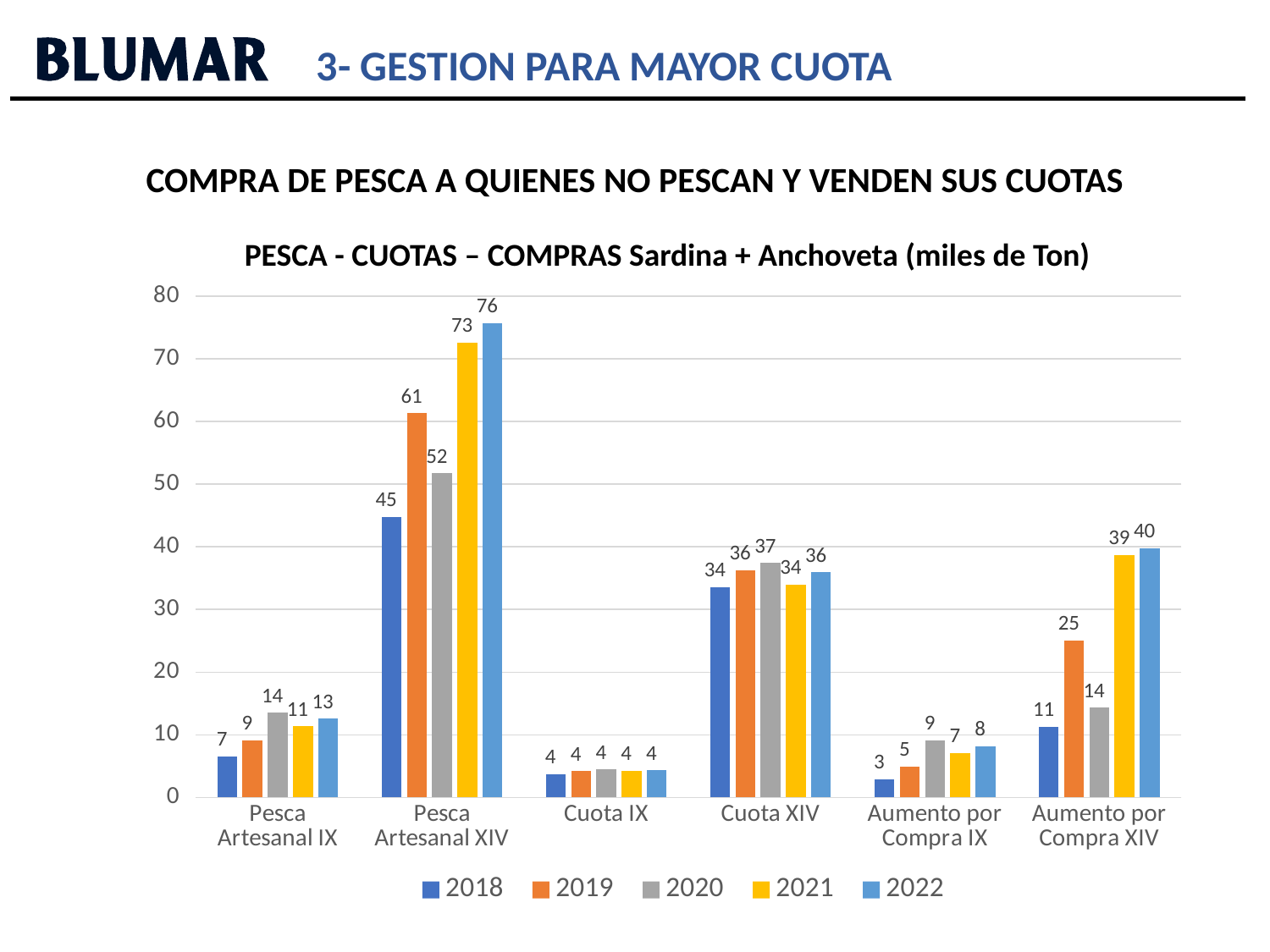
Is the value for 2021 in the Pesca Artesanal XIV category greater or less than 70? greater Which is larger in the Cuota XIV category, the value for 2020 or the value for 2021? 2020 How many categories are shown on the x axis? 6 How many series does the legend list? 5 What is the value for 2019 in the Aumento por Compra XIV category? 25 What is the title of the chart? PESCA - CUOTAS – COMPRAS Sardina + Anchoveta (miles de Ton) What is the value for 2018 in the Aumento por Compra IX category? 3 What is the difference between the 2022 and 2018 values in the Pesca Artesanal XIV category? 31 Which year has the lowest value in the Aumento por Compra XIV category? 2018 What is the value for 2022 in the Pesca Artesanal XIV category? 76 What kind of chart is shown on the slide? bar chart Which year has the highest value in the Pesca Artesanal XIV category? 2022